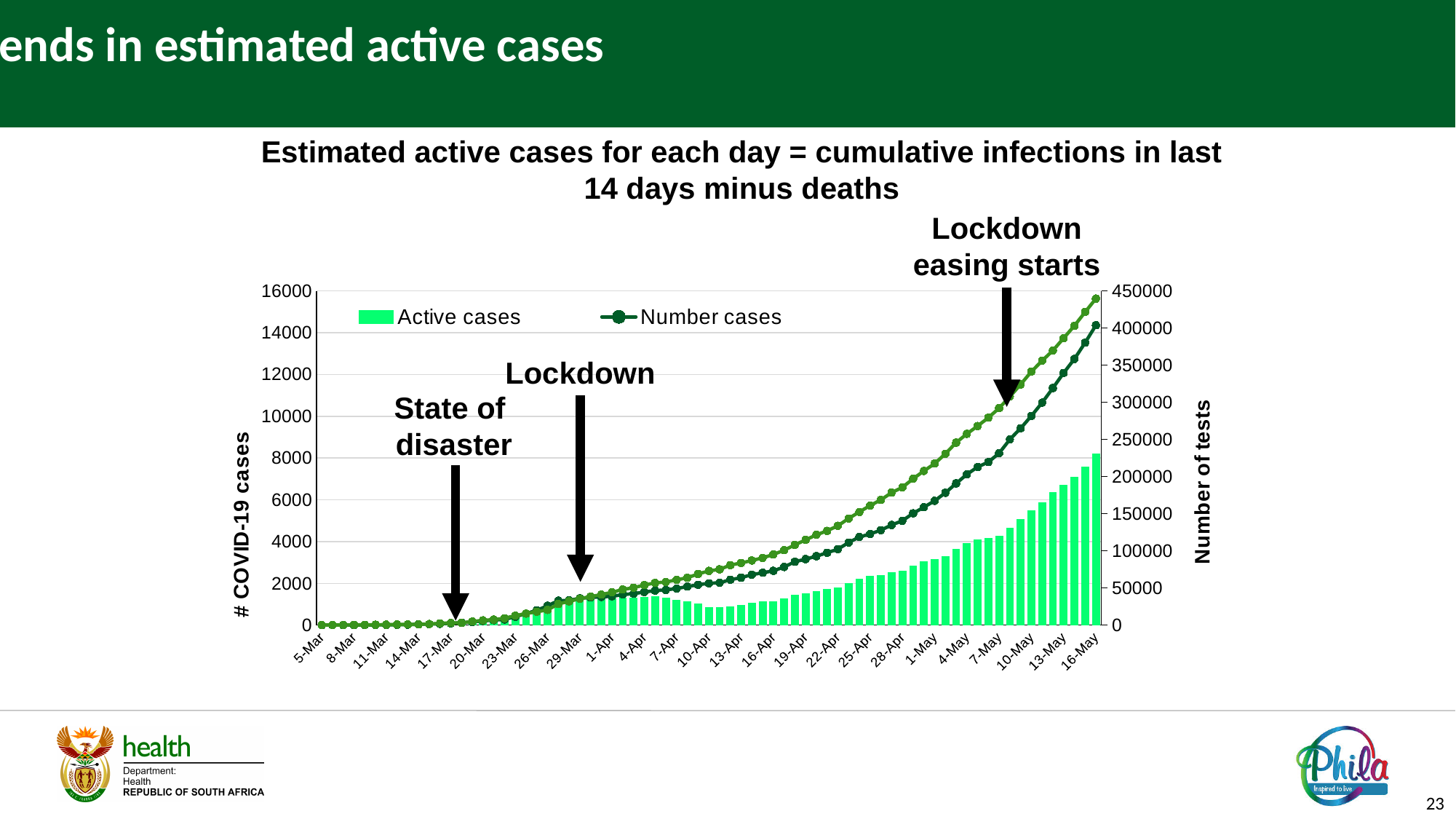
Is the value of Active cases on 10-Apr greater or less than 2000? less How many series does the chart legend list? 2 On which date are Active cases highest? 16-May Which is larger, Active cases on 16-May or Active cases on 1-May? 16-May Is the value of Active cases on 1-May greater or less than 4000? less Is the value of Active cases on 13-May greater or less than 8000? less What is the label of the left vertical axis? # COVID-19 cases Do the Active cases bars generally rise or fall from 5-Mar to 16-May? Rise Which two series are listed in the chart legend? Active cases and Number cases What kind of chart is shown on the slide? A combined bar and line chart